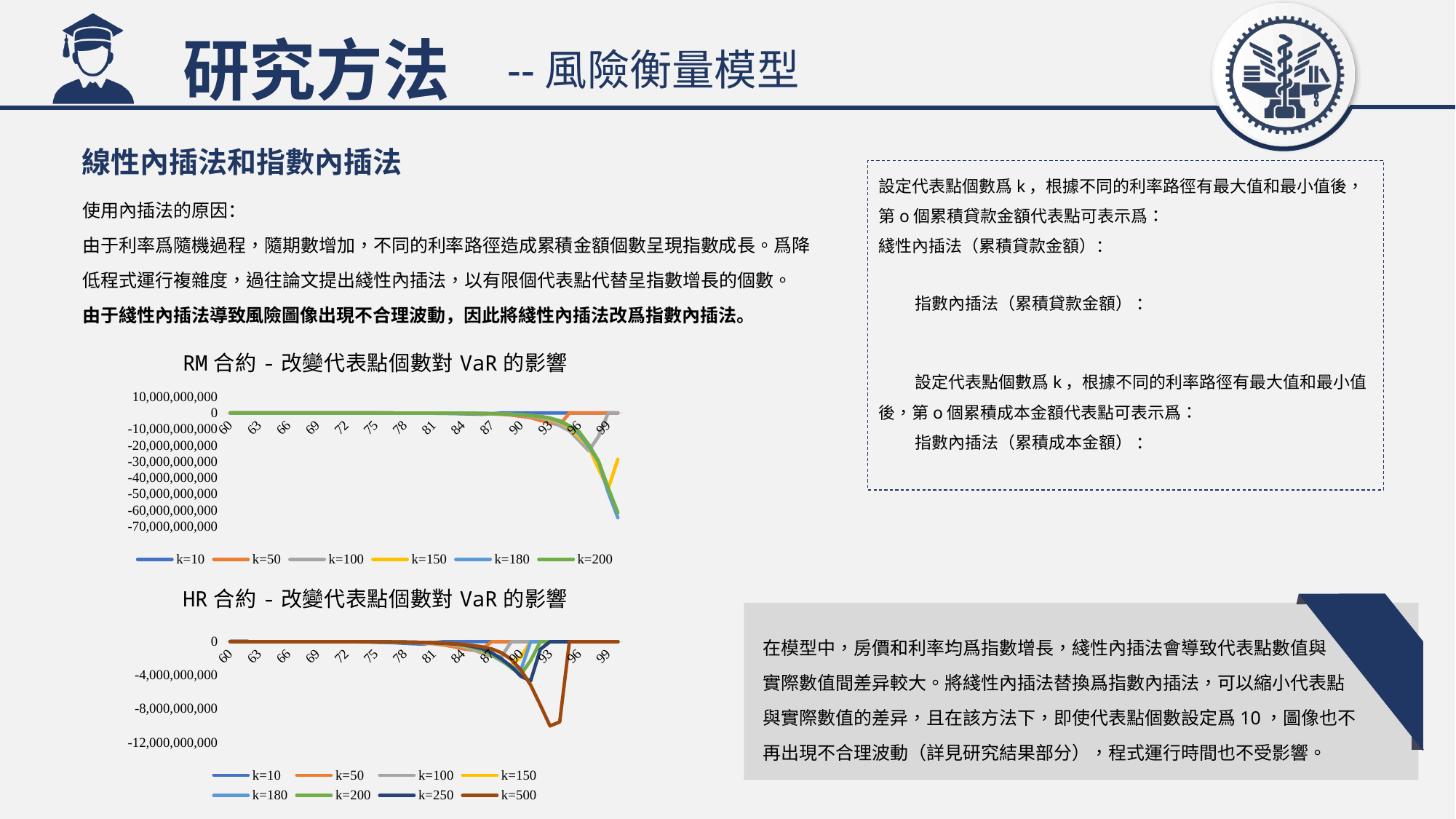
What kind of chart is the 'RM 合約 - 改變代表點個數對 VaR 的影響' chart? line chart In the 'RM 合約 - 改變代表點個數對 VaR 的影響' chart, is the lowest point reached by the k=200 series greater or less than -50,000,000,000? less In the 'HR 合約 - 改變代表點個數對 VaR 的影響' chart, is the minimum value of the k=500 series greater or less than -8,000,000,000? less In the 'RM 合約 - 改變代表點個數對 VaR 的影響' chart, do the series values generally rise or fall as the x axis moves from 90 toward 99? fall How many tick labels are shown on the x axis of the 'HR 合約 - 改變代表點個數對 VaR 的影響' chart? 14 What is the lowest value shown on the vertical axis of the 'RM 合約 - 改變代表點個數對 VaR 的影響' chart? -70,000,000,000 How many series does the legend of the 'HR 合約 - 改變代表點個數對 VaR 的影響' chart list? 8 What kind of chart is the 'HR 合約 - 改變代表點個數對 VaR 的影響' chart? line chart What is the first x-axis tick label on the 'RM 合約 - 改變代表點個數對 VaR 的影響' chart? 60 In the 'HR 合約 - 改變代表點個數對 VaR 的影響' chart, which legend entry has the largest k value? k=500 How many series does the legend of the 'RM 合約 - 改變代表點個數對 VaR 的影響' chart list? 6 In the 'HR 合約 - 改變代表點個數對 VaR 的影響' chart, is the value of the k=500 series at x=60 greater or less than -4,000,000,000? greater